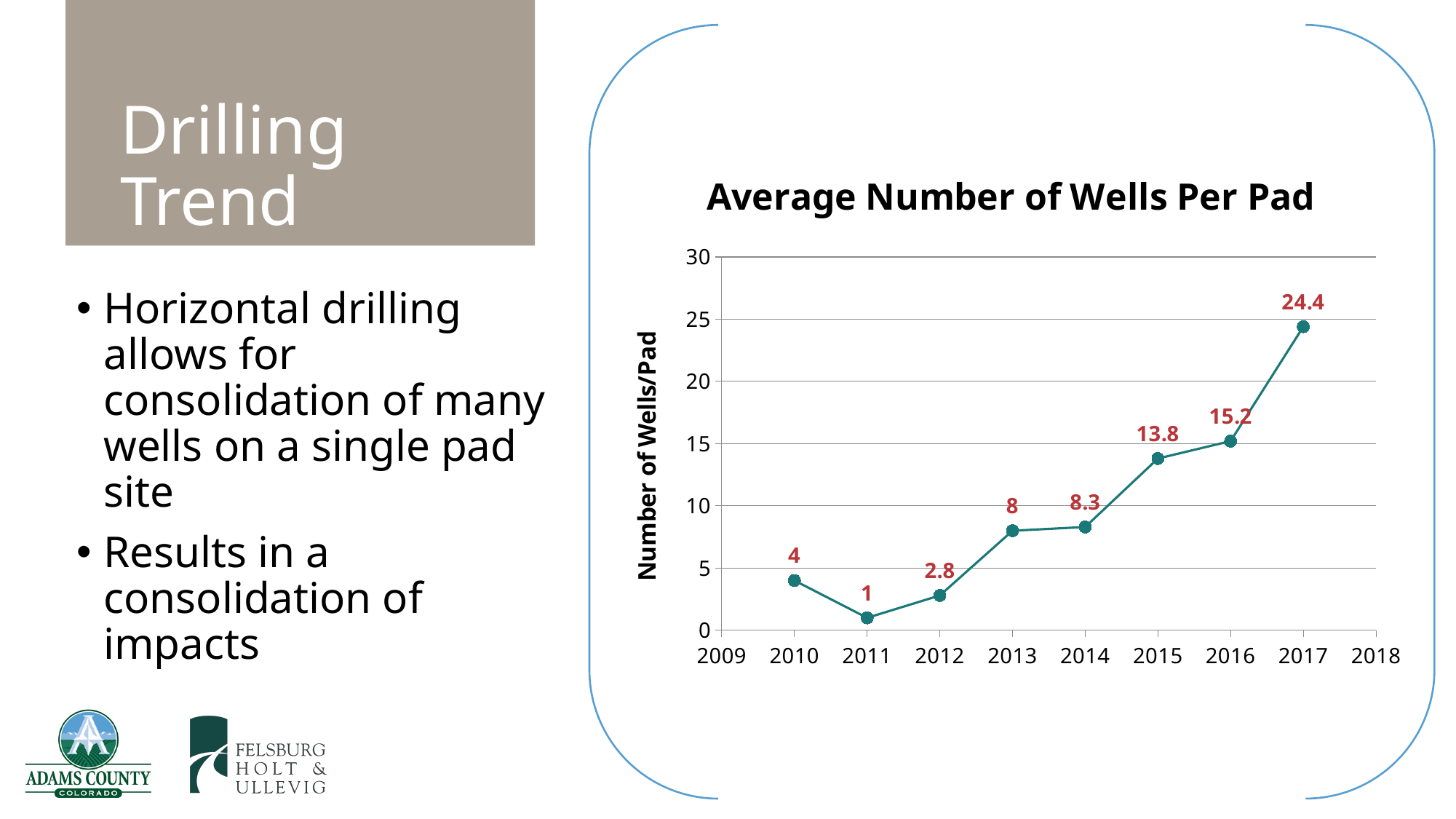
What is the difference between the average number of wells per pad in 2017 and in 2016? 9.2 What is the average number of wells per pad in 2017? 24.4 Which year has a higher average number of wells per pad, 2010 or 2012? 2010 Which year has the lowest average number of wells per pad? 2011 What kind of chart is shown on the slide? Line chart What is the difference between the average number of wells per pad in 2015 and in 2014? 5.5 Which year has the highest average number of wells per pad? 2017 Is the value for 2016 greater or less than 20? less What is the title of the chart? Average Number of Wells Per Pad How many data points are plotted on the chart? 8 What is the average number of wells per pad in 2014? 8.3 What is the average number of wells per pad in 2011? 1